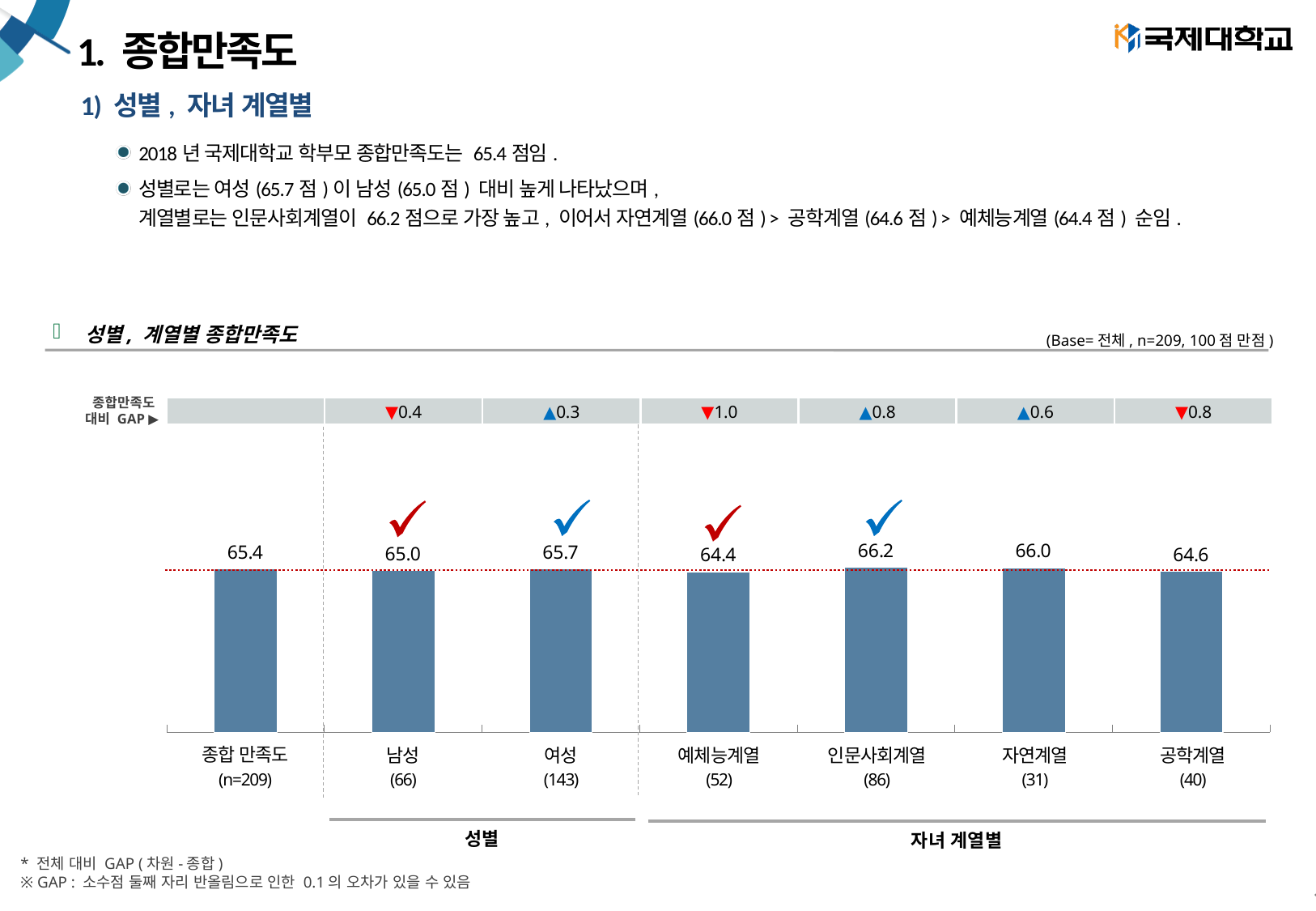
Which is larger, the value for 자연계열 or the value for 공학계열? 자연계열 What is the value for 인문사회계열 (86)? 66.2 What is the difference between the values for 여성 and 남성? 0.7 What kind of chart is this? bar chart What is the value for 종합 만족도 (n=209)? 65.4 What is the difference between the values for 인문사회계열 and 예체능계열? 1.8 Which category has the highest value? 인문사회계열 What GAP value is shown above the 예체능계열 bar? ▼1.0 What is the value for 여성 (143)? 65.7 What is the value for 남성 (66)? 65.0 How many bars are shown in the chart? 7 Which category has the lowest value? 예체능계열